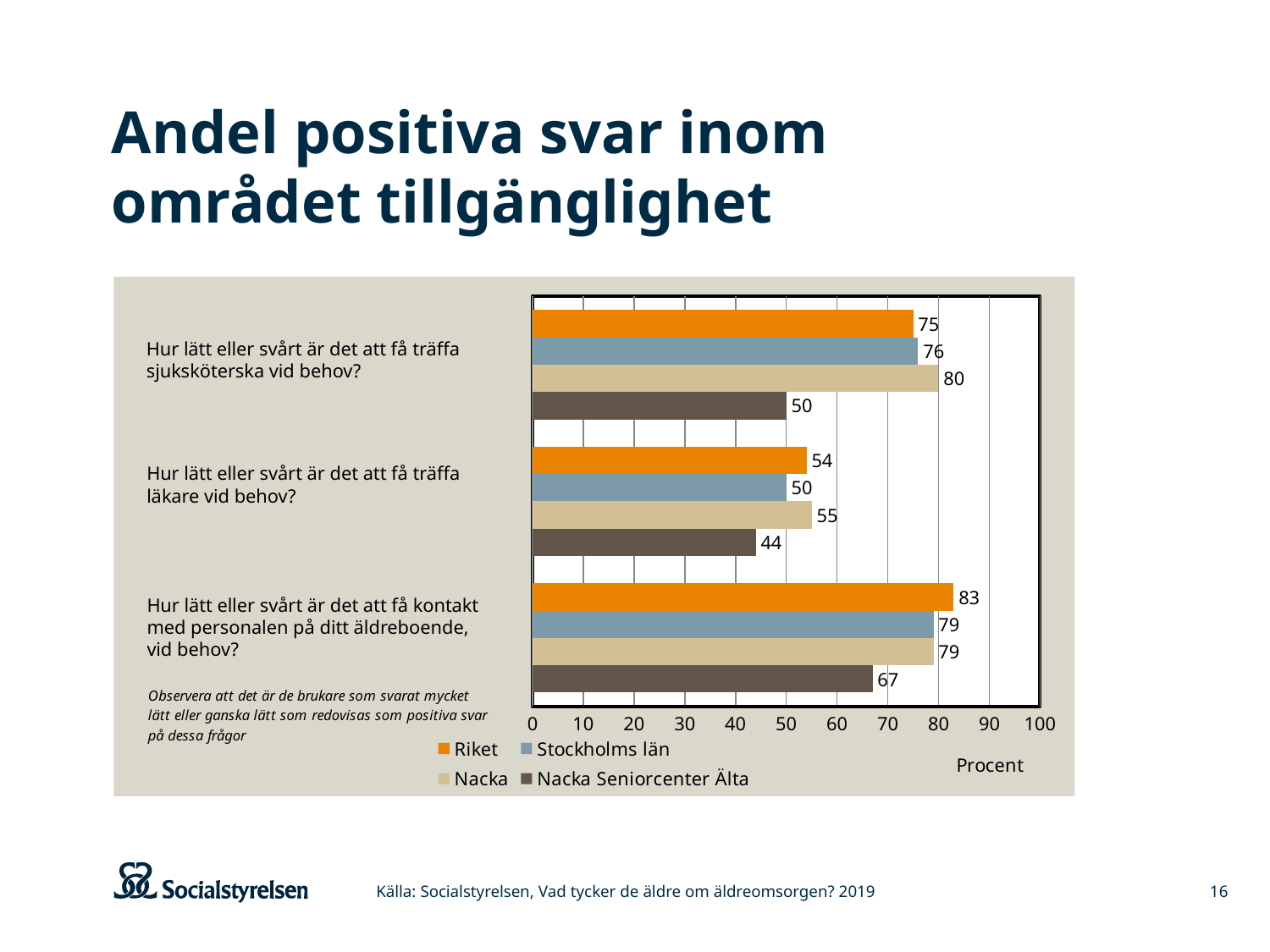
Which series has the highest value for 'Hur lätt eller svårt är det att få kontakt med personalen på ditt äldreboende, vid behov?' Riket Which series has the lowest value for 'Hur lätt eller svårt är det att få träffa sjuksköterska vid behov?' Nacka Seniorcenter Älta What is the value for Nacka Seniorcenter Älta for 'Hur lätt eller svårt är det att få träffa läkare vid behov?' 44 What is the difference between Nacka and Nacka Seniorcenter Älta for 'Hur lätt eller svårt är det att få träffa sjuksköterska vid behov?' 30 How many series does the legend list? 4 What is the difference between Riket and Nacka Seniorcenter Älta for 'Hur lätt eller svårt är det att få kontakt med personalen på ditt äldreboende, vid behov?' 16 What is the label of the x axis? Procent What kind of chart is shown on the slide? Bar chart Which is larger for 'Hur lätt eller svårt är det att få träffa läkare vid behov?': Riket or Nacka Seniorcenter Älta? Riket What is the value for Riket for 'Hur lätt eller svårt är det att få kontakt med personalen på ditt äldreboende, vid behov?' 83 How many question categories are plotted on the chart? 3 What is the value for Nacka for 'Hur lätt eller svårt är det att få träffa sjuksköterska vid behov?' 80